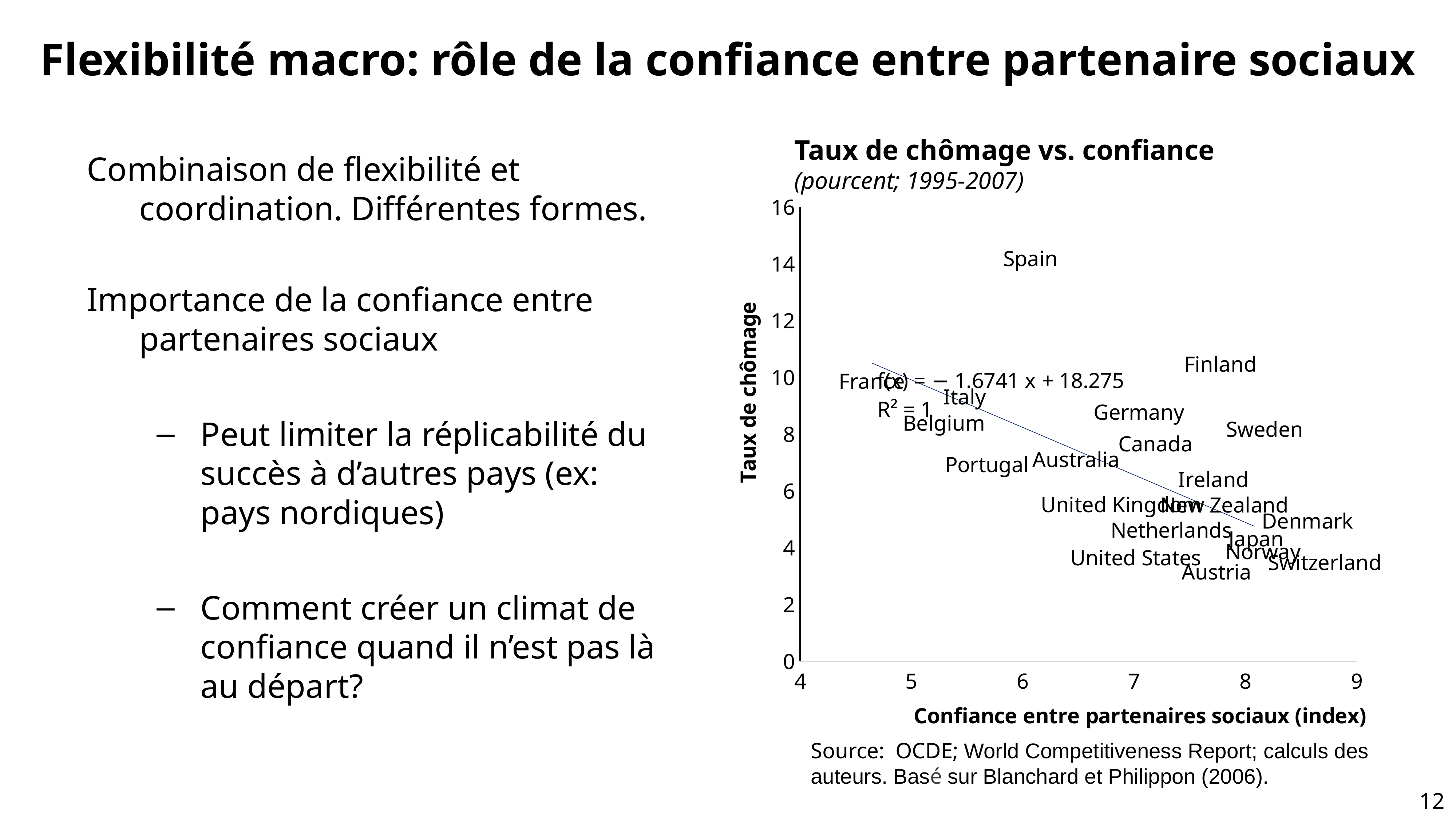
What is the equation of the fitted line shown on the chart? f(x) = − 1.6741 x + 18.275 Is the unemployment rate for Spain greater or less than 12? greater Which country has the highest unemployment rate (Taux de chômage) in the chart? Spain As the confidence index increases along the x axis, does the unemployment rate generally rise or fall? fall What is the title of the chart? Taux de chômage vs. confiance What kind of chart is shown on the slide? scatter chart Which has a higher unemployment rate, Spain or Finland? Spain Which has a higher unemployment rate, Germany or Austria? Germany Which country has a higher confidence index, Switzerland or France? Switzerland Is the unemployment rate for Germany greater or less than 8? greater Is the unemployment rate for Denmark greater or less than 6? less